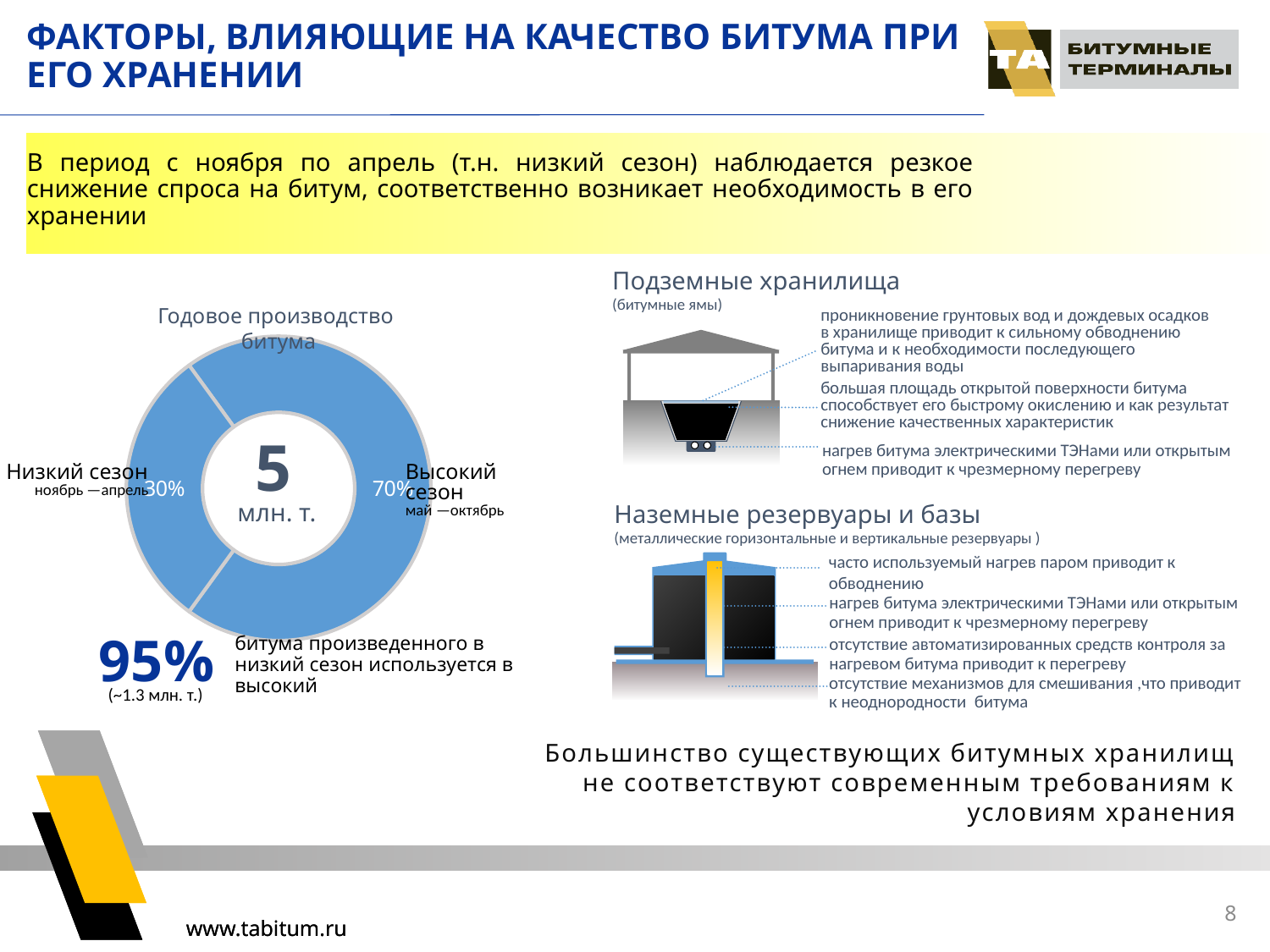
Which season has the smaller share of annual bitumen production? Низкий сезон Which season has the larger share of annual bitumen production? Высокий сезон What is the title of the donut chart on the slide? Годовое производство битума What percentage of bitumen produced in the low season is used in the high season, according to the figure below the chart? 95% What total annual bitumen production is shown in the centre of the donut chart? 5 млн. т. What kind of chart is used to show the annual bitumen production split? Donut (pie) chart What share of annual bitumen production falls in the low season (Низкий сезон)? 30% How many slices does the donut chart have? 2 What share of annual bitumen production falls in the high season (Высокий сезон)? 70% Which months does the low season (Низкий сезон) cover according to the chart labels? ноябрь — апрель Is the share for Высокий сезон larger or smaller than the share for Низкий сезон? Larger By how many percentage points does the high season share exceed the low season share? 40 percentage points